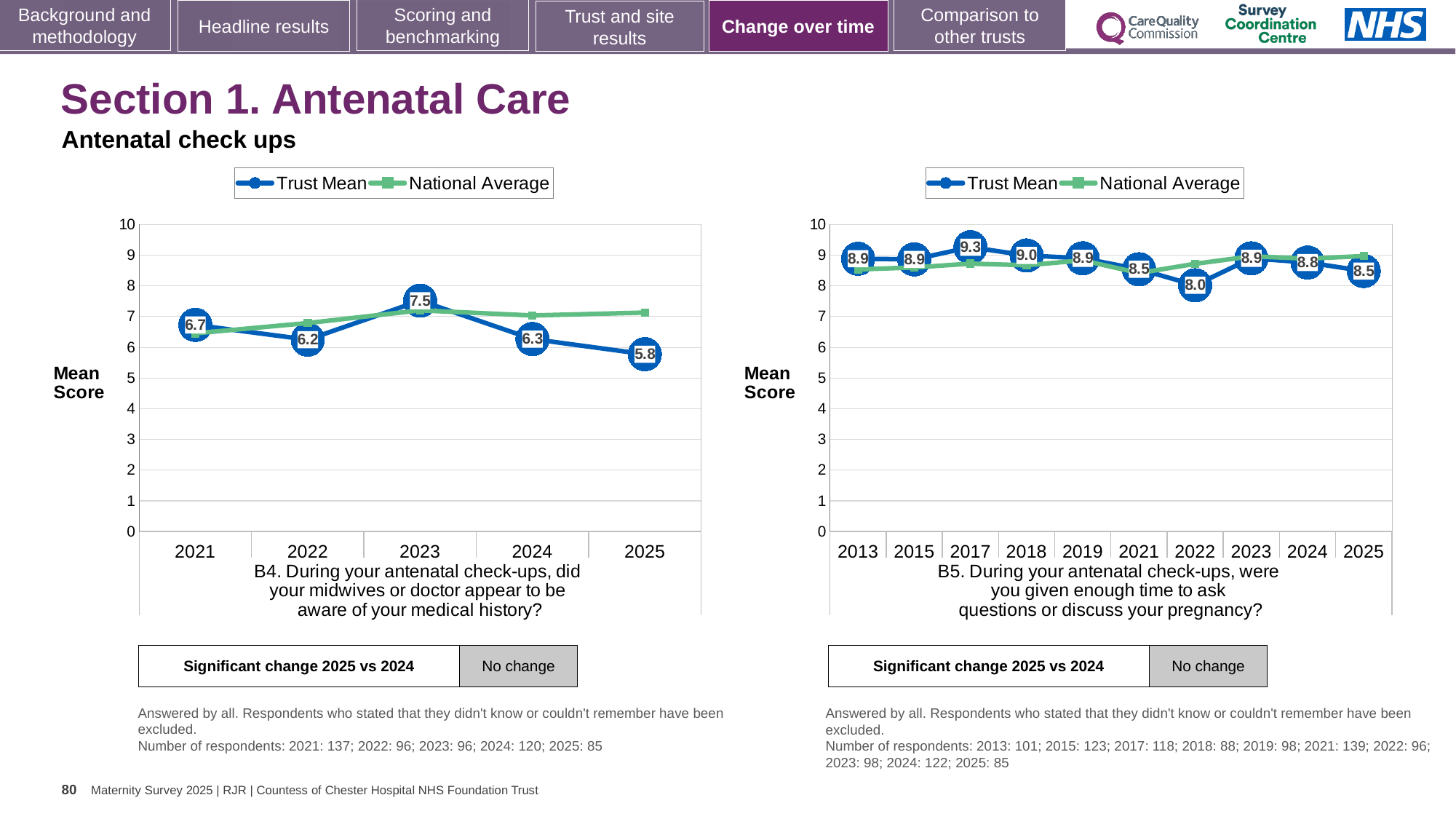
In the right chart (B5), is the Trust Mean for 2017 greater or less than 9? greater In the left chart (B4), what is the Trust Mean for 2023? 7.5 In the right chart (B5), how many series does the legend list? 2 In the left chart (B4), which year has the highest Trust Mean? 2023 In the left chart (B4), what is the difference between the Trust Mean in 2023 and in 2025? 1.7 In the left chart (B4), what is the Trust Mean for 2025? 5.8 In the right chart (B5), how many years are shown on the x axis? 10 In the right chart (B5), which year has the highest Trust Mean? 2017 What type of chart is the left chart (B4)? Line chart In the right chart (B5), what is the Trust Mean for 2022? 8.0 In the left chart (B4), how many years are shown on the x axis? 5 In the left chart (B4), which year has the lowest Trust Mean? 2025